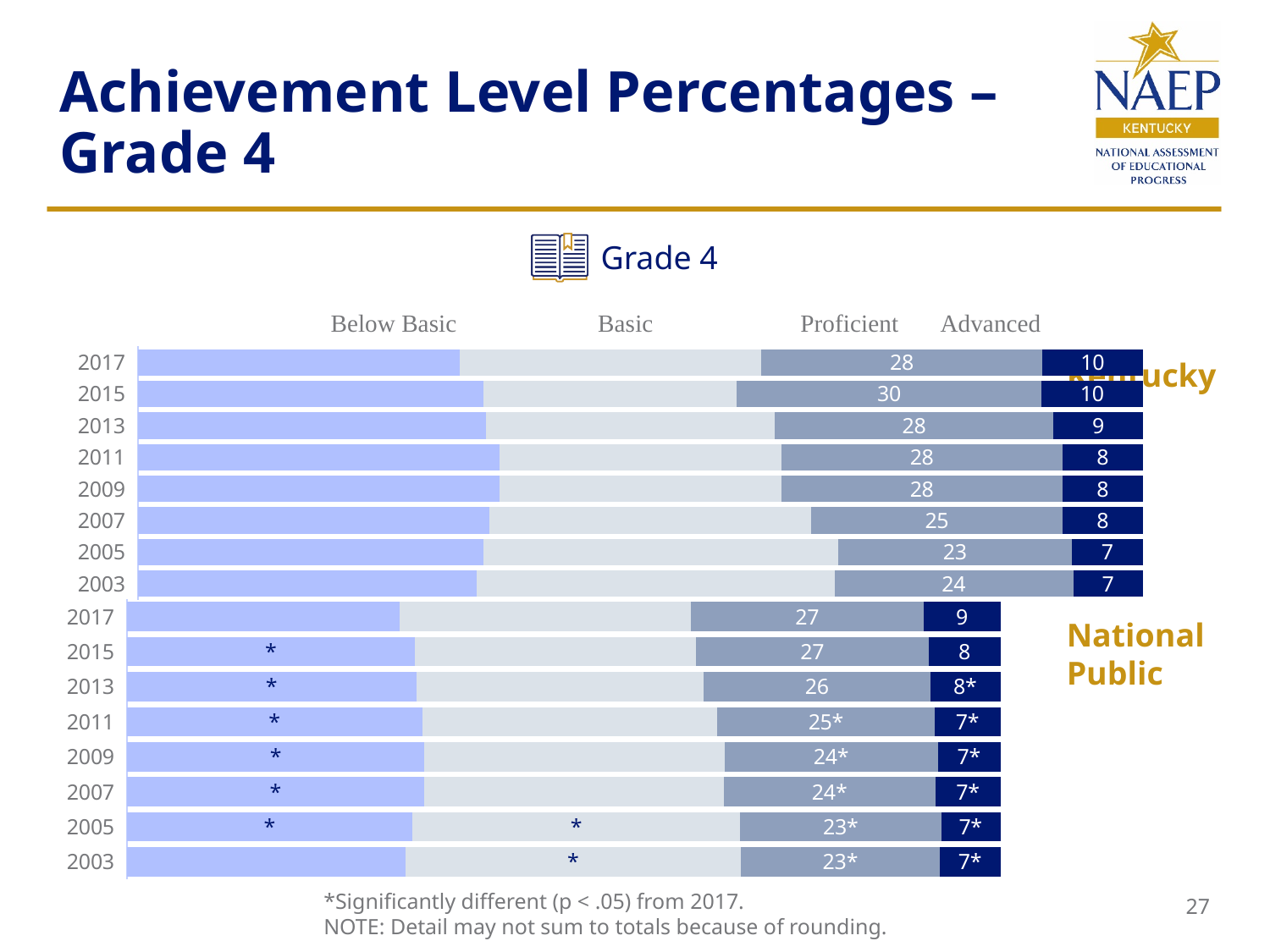
In the Kentucky chart, which year has the highest Proficient percentage? 2015 For 2017, which is larger: the Advanced percentage in the Kentucky chart or in the National Public chart? Kentucky In the Kentucky chart, which year has the lowest Proficient percentage? 2005 In the Kentucky chart, does the Advanced percentage rise or fall from 2003 to 2017? Rise How many achievement levels are listed across the top of the charts? 4 In the National Public chart, what is the Proficient value shown for 2011? 25* In the Kentucky chart, what is the difference between the Proficient percentage in 2015 and in 2005? 7 What kind of chart is used to show the achievement level percentages? Stacked bar chart In the Kentucky chart, what percentage of students were at the Advanced level in 2003? 7 In the National Public chart, what is the Advanced value shown for 2017? 9 How many years are shown in the Kentucky chart? 8 In the Kentucky chart, what percentage of students were at the Proficient level in 2015? 30